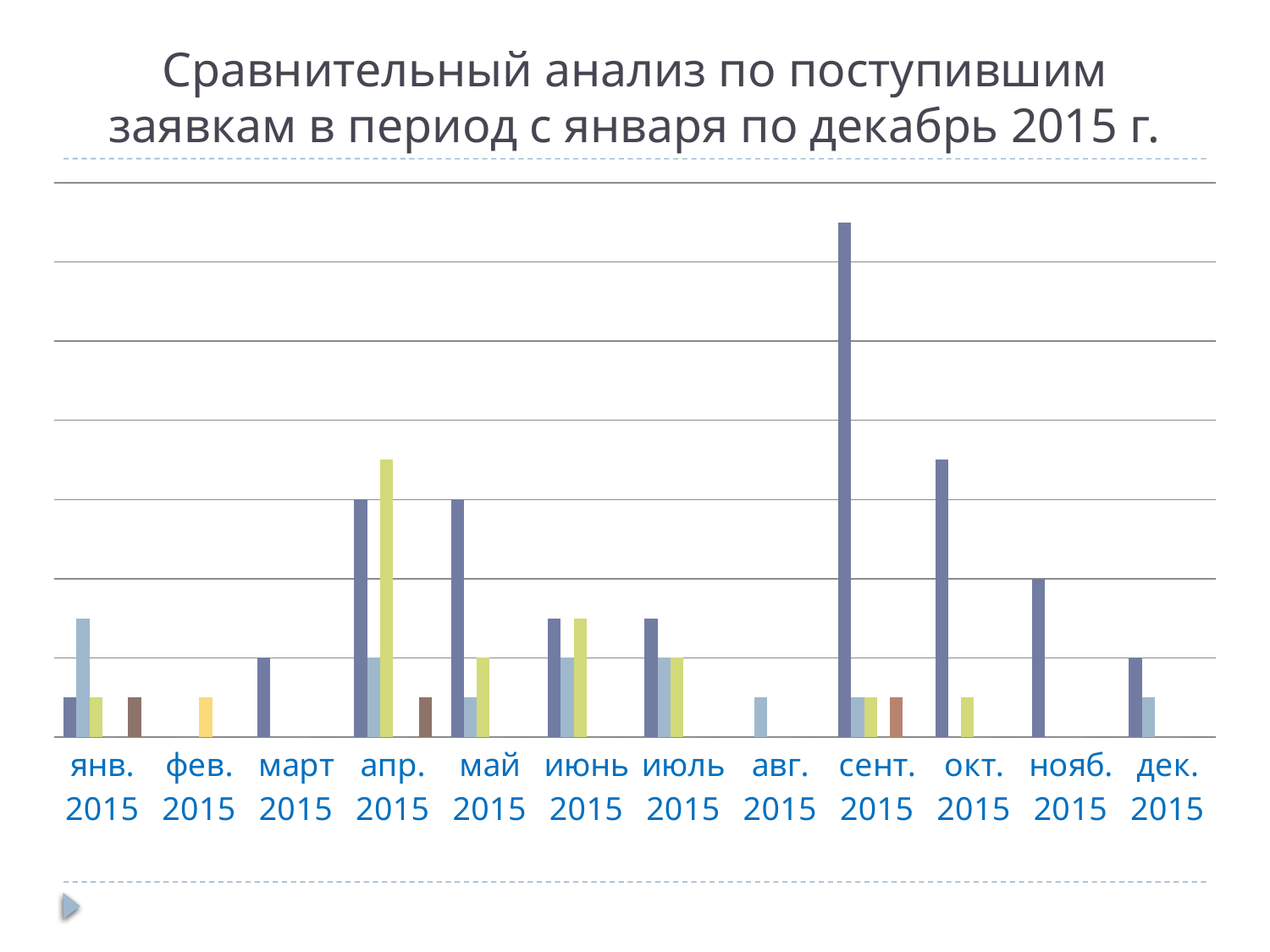
What kind of chart is shown on the slide? bar chart How many months (categories) are shown on the x axis of the chart? 12 Which month has the tallest light blue bar? янв. 2015 Which month has the tallest bar in the chart? сент. 2015 Which is taller: the dark blue bar for нояб. 2015 or the dark blue bar for дек. 2015? нояб. 2015 Does the chart display a legend? No What is the title of the chart on the slide? Сравнительный анализ по поступившим заявкам в период с января по декабрь 2015 г. Which is taller: the dark blue bar for март 2015 or the dark blue bar for май 2015? май 2015 Which month has the tallest yellow-green bar? апр. 2015 Which is taller: the dark blue bar for сент. 2015 or the dark blue bar for окт. 2015? сент. 2015